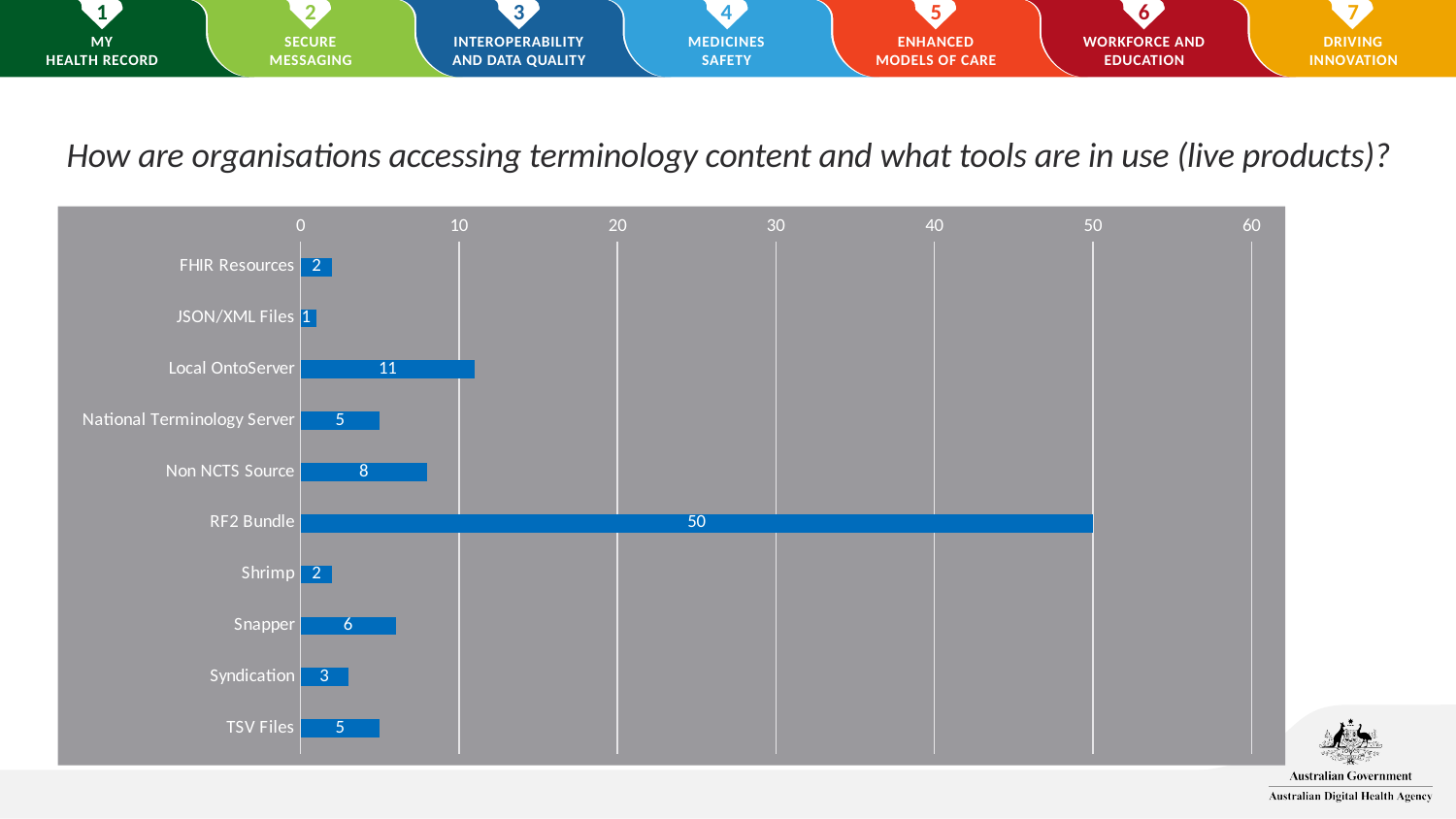
Which category has the lowest value? JSON/XML Files What is the value for RF2 Bundle? 50 What is the value for Non NCTS Source? 8 Which category has the highest value? RF2 Bundle What is the value for Local OntoServer? 11 What is the value for JSON/XML Files? 1 What is the title of the slide above the chart? How are organisations accessing terminology content and what tools are in use (live products)? What kind of chart is shown on the slide? Bar chart What is the difference between the values for RF2 Bundle and Local OntoServer? 39 Which is larger, the value for Snapper or the value for Syndication? Snapper How many categories are shown in the chart? 10 Is the value for Local OntoServer greater or less than 10? greater